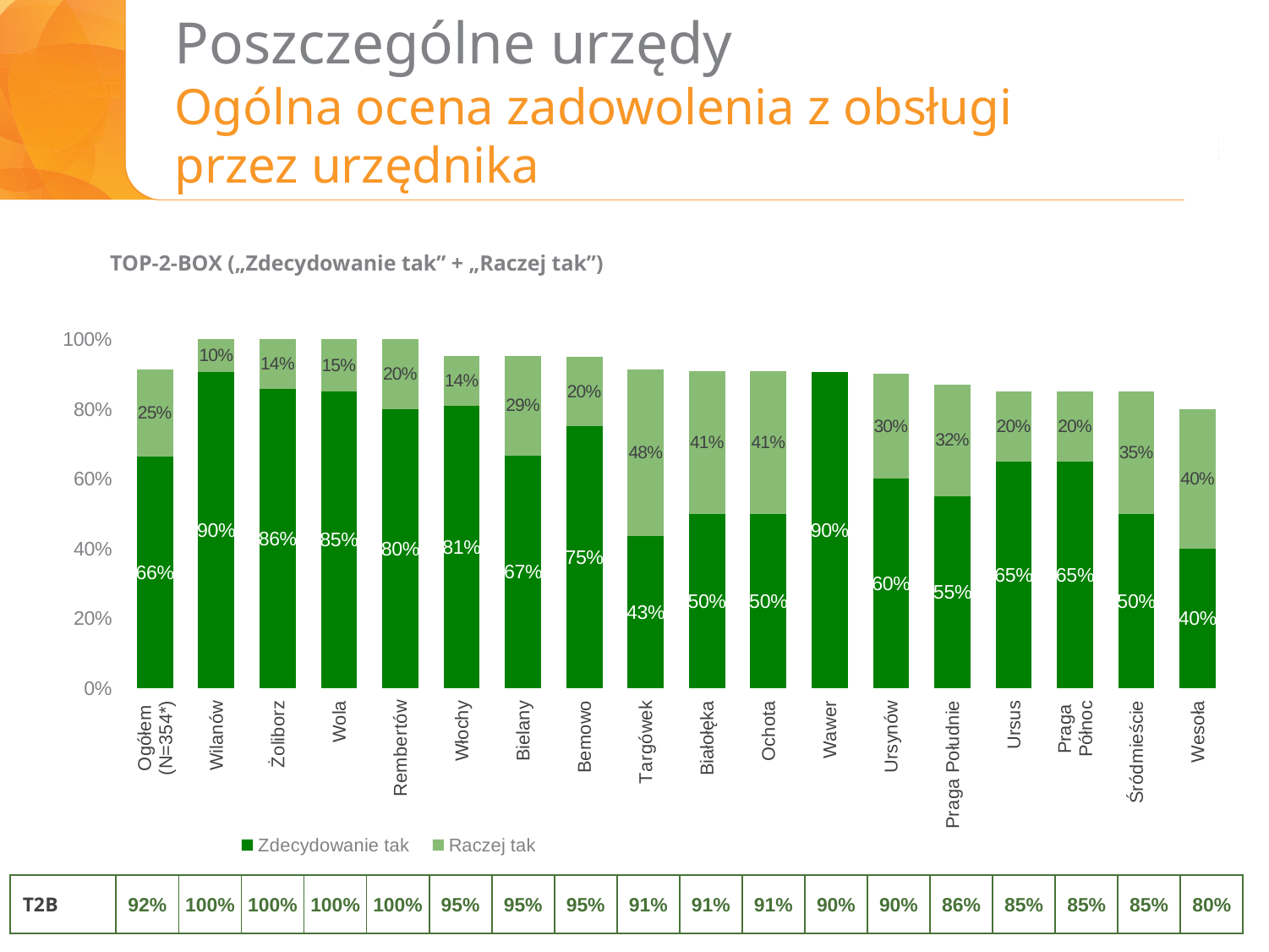
Which category has the highest "Raczej tak" value? Targówek How many categories are shown on the x axis of the chart? 18 What are the two legend entries of the chart? Zdecydowanie tak, Raczej tak How many series does the legend list? 2 What is the T2B value for Wesoła? 80% Do the T2B values rise or fall along the x axis from Wilanów to Wesoła? Fall Which category has the lowest "Zdecydowanie tak" value? Wesoła What is the difference between the "Zdecydowanie tak" values for Wilanów and Wesoła? 50 percentage points What kind of chart is shown on the slide? Stacked bar chart What is the "Raczej tak" value for Targówek? 48% Which has the larger "Zdecydowanie tak" value, Bemowo or Bielany? Bemowo What is the "Zdecydowanie tak" value for Bielany? 67%